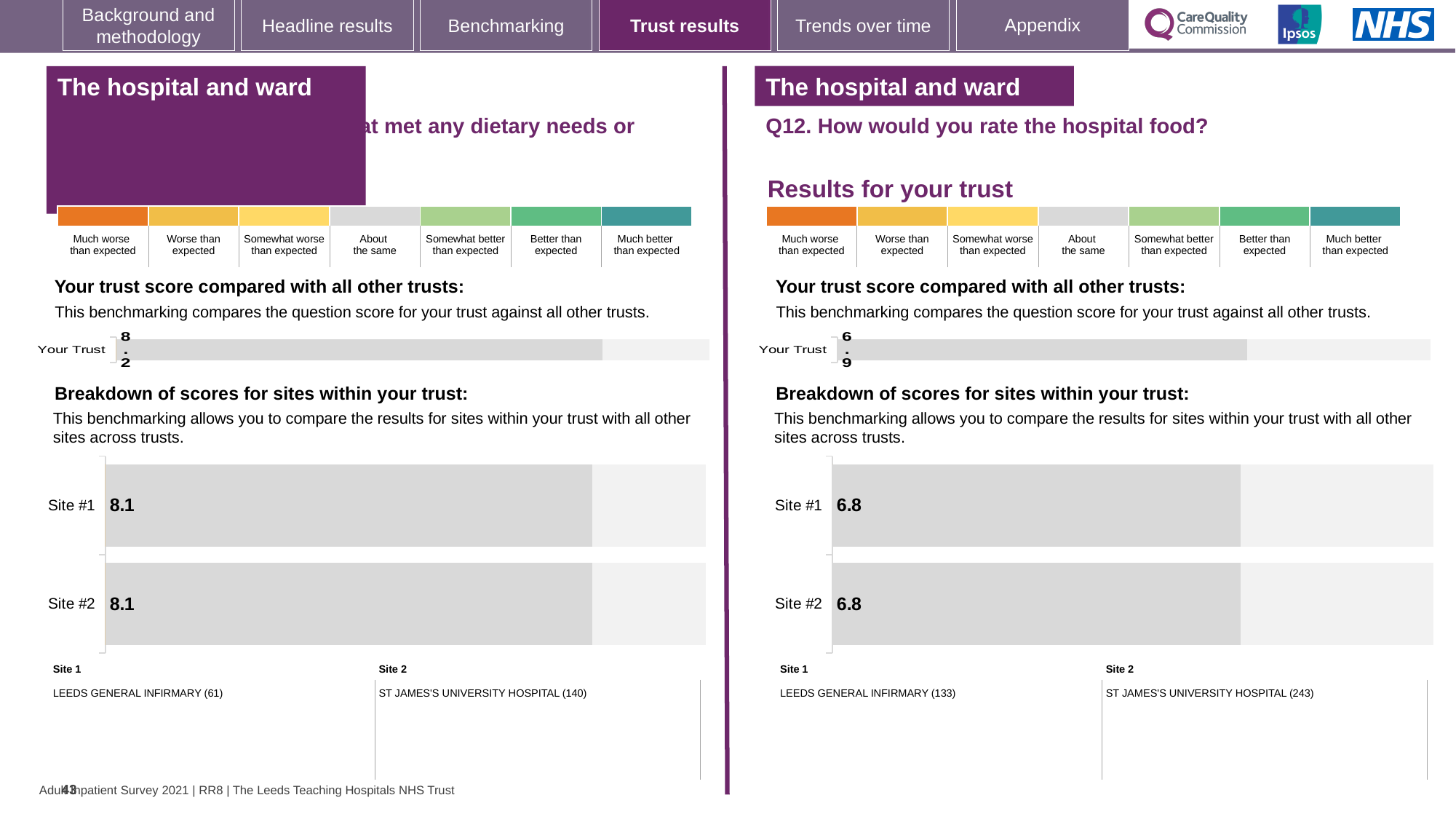
Which is larger: the 'Your Trust' score on the left-hand section (8.2) or the 'Your Trust' score for Q12 hospital food (6.9)? The left-hand section (8.2) What kind of chart is used for the breakdown of scores for sites within your trust on the Q12 hospital food section? Bar chart How many sites are shown in the Q12 hospital food breakdown chart? 2 On the left-hand section of the slide, what is the 'Your Trust' score shown in the trust comparison bar? 8.2 On the Q12 hospital food breakdown chart, what is the score for Site #1? 6.8 On the left-hand breakdown chart of scores for sites within your trust, what is the score for Site #2? 8.1 On the Q12 hospital food breakdown chart, what is the score for Site #2? 6.8 On the Q12 hospital food section, which hospital is listed as Site 1 below the breakdown chart? LEEDS GENERAL INFIRMARY (133) On the Q12 hospital food section, which hospital is listed as Site 2 below the breakdown chart? ST JAMES'S UNIVERSITY HOSPITAL (243) What is the difference between the 'Your Trust' score on the left-hand section (8.2) and the 'Your Trust' score for Q12 hospital food (6.9)? 1.3 On the right-hand slide section for Q12 (How would you rate the hospital food?), what is the 'Your Trust' score? 6.9 On the left-hand breakdown chart of scores for sites within your trust, what is the score for Site #1? 8.1